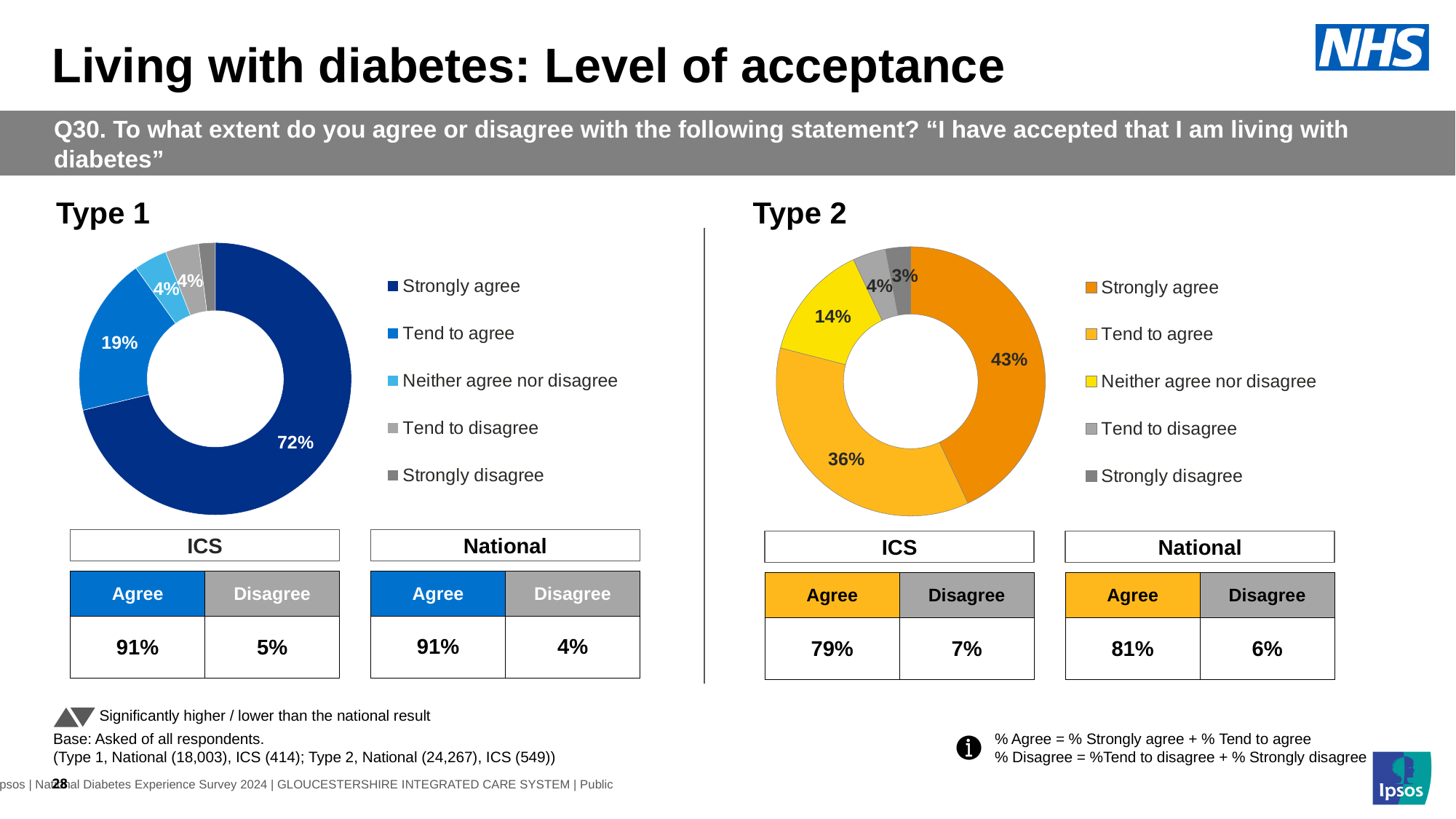
In the Type 2 chart, which response category has the largest share? Strongly agree In the Type 2 chart, what is the difference between the Strongly agree and Tend to agree shares? 7% Which is larger: the Strongly agree share in the Type 1 chart or the Strongly agree share in the Type 2 chart? Type 1 In the Type 1 chart, which response category has the largest share? Strongly agree In the Type 2 chart, what percentage of respondents neither agree nor disagree? 14% In the Type 1 chart, what colour is the Strongly agree slice? Dark blue In the Type 2 chart, what percentage of respondents strongly agree? 43% In the Type 2 chart, what percentage of respondents strongly disagree? 3% What kind of chart is used for the Type 1 data? Donut (pie) chart In the Type 1 chart, what percentage of respondents tend to agree? 19% How many response categories does the legend of the Type 2 chart list? 5 In the Type 1 chart, what percentage of respondents strongly agree? 72%